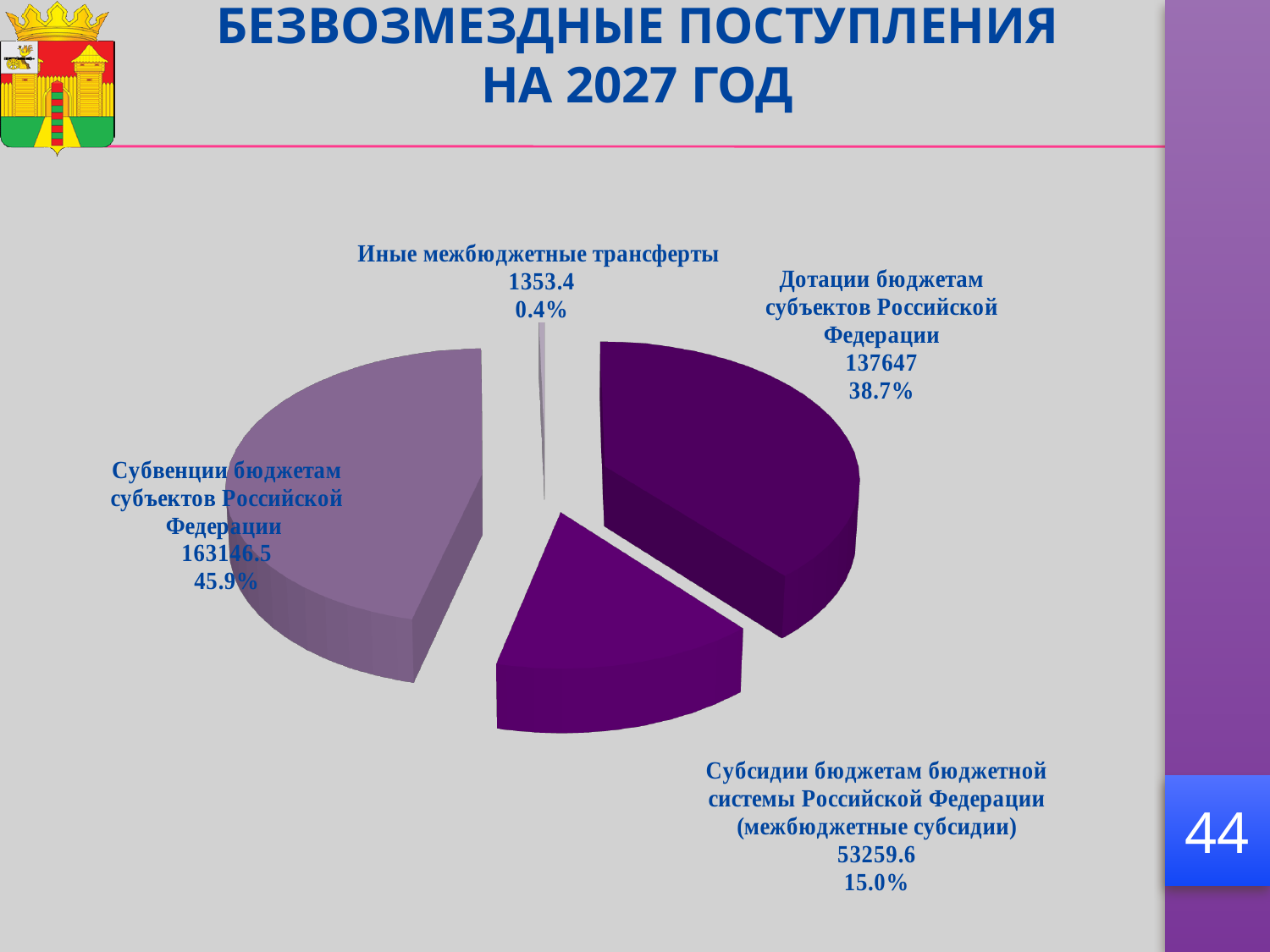
Which category has the largest slice? Субвенции бюджетам субъектов Российской Федерации Which is larger: Дотации бюджетам субъектов Российской Федерации or Субсидии бюджетам бюджетной системы Российской Федерации (межбюджетные субсидии)? Дотации бюджетам субъектов Российской Федерации What share of the pie do Субсидии бюджетам бюджетной системы Российской Федерации (межбюджетные субсидии) represent? 15.0% What is the value for Иные межбюджетные трансферты? 1353.4 What is the value for Субвенции бюджетам субъектов Российской Федерации? 163146.5 What kind of chart is shown on the slide? Pie chart What is the value for Дотации бюджетам субъектов Российской Федерации? 137647 Which category has the smallest slice? Иные межбюджетные трансферты What share of the pie do Субвенции бюджетам субъектов Российской Федерации represent? 45.9% What is the difference between the values for Субвенции бюджетам субъектов Российской Федерации and Дотации бюджетам субъектов Российской Федерации? 25499.5 How many slices does the pie chart have? 4 What is the title of the slide containing the chart? БЕЗВОЗМЕЗДНЫЕ ПОСТУПЛЕНИЯ НА 2027 ГОД